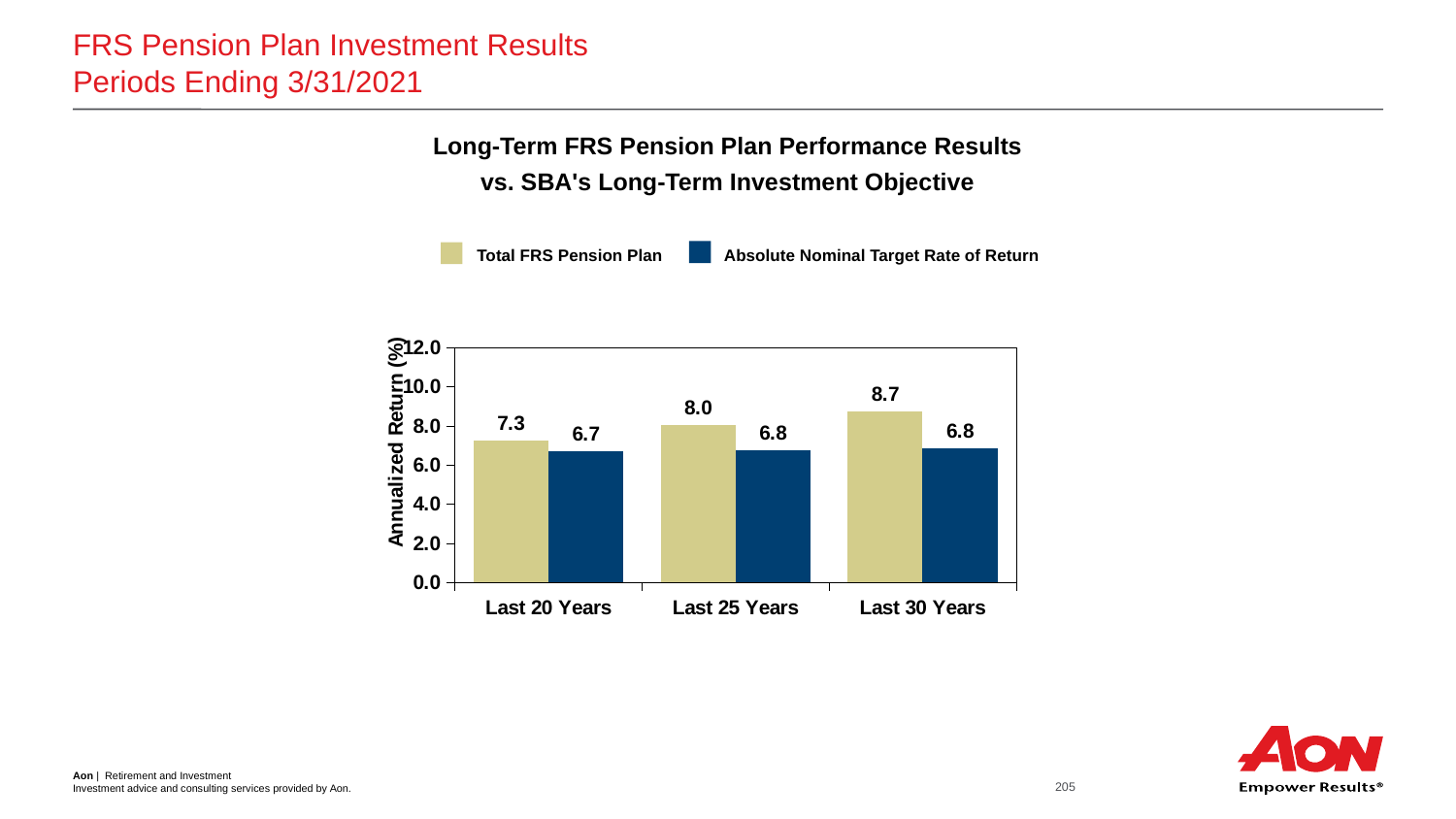
What is the difference between the Total FRS Pension Plan and the Absolute Nominal Target Rate of Return for Last 30 Years? 1.9 How many periods are shown on the x axis? 3 Do the Total FRS Pension Plan values rise or fall from Last 20 Years to Last 30 Years? rise What is the value for Absolute Nominal Target Rate of Return for Last 25 Years? 6.8 Is the Total FRS Pension Plan value for Last 30 Years greater or less than 8.0? greater Which is larger for Last 25 Years: Total FRS Pension Plan or Absolute Nominal Target Rate of Return? Total FRS Pension Plan How many series does the legend list? 2 Which period has the highest Total FRS Pension Plan value? Last 30 Years What kind of chart is shown on the slide? bar chart Which period has the lowest Absolute Nominal Target Rate of Return value? Last 20 Years What is the value for Total FRS Pension Plan for Last 20 Years? 7.3 What is the value for Total FRS Pension Plan for Last 30 Years? 8.7